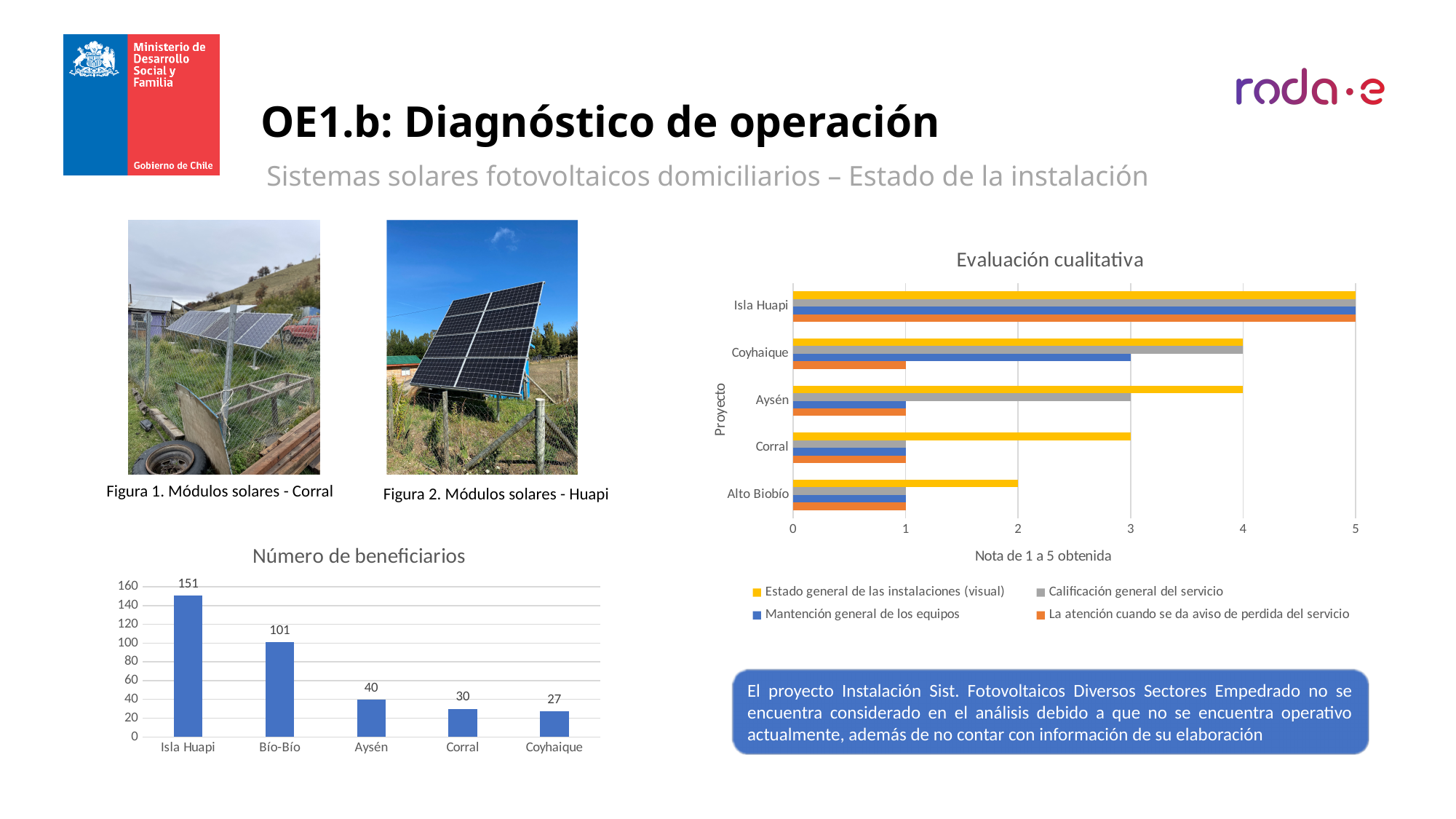
In the 'Número de beneficiarios' chart, which is larger, Aysén or Corral? Aysén What is the x-axis title of the 'Evaluación cualitativa' chart? Nota de 1 a 5 obtenida How many categories are shown in the 'Número de beneficiarios' chart? 5 In the 'Número de beneficiarios' chart, what is the difference between Isla Huapi and Bío-Bío? 50 In the 'Evaluación cualitativa' chart, what is the value of 'Estado general de las instalaciones (visual)' for Alto Biobío? 2 What kind of chart is 'Número de beneficiarios'? Bar chart In the 'Evaluación cualitativa' chart, which project has the highest value for 'La atención cuando se da aviso de perdida del servicio'? Isla Huapi In the 'Evaluación cualitativa' chart, what is the value of 'Mantención general de los equipos' for Coyhaique? 3 In the 'Número de beneficiarios' chart, what is the value for Isla Huapi? 151 How many series does the legend of the 'Evaluación cualitativa' chart list? 4 In the 'Número de beneficiarios' chart, which category has the lowest value? Coyhaique In the 'Número de beneficiarios' chart, what is the value for Bío-Bío? 101